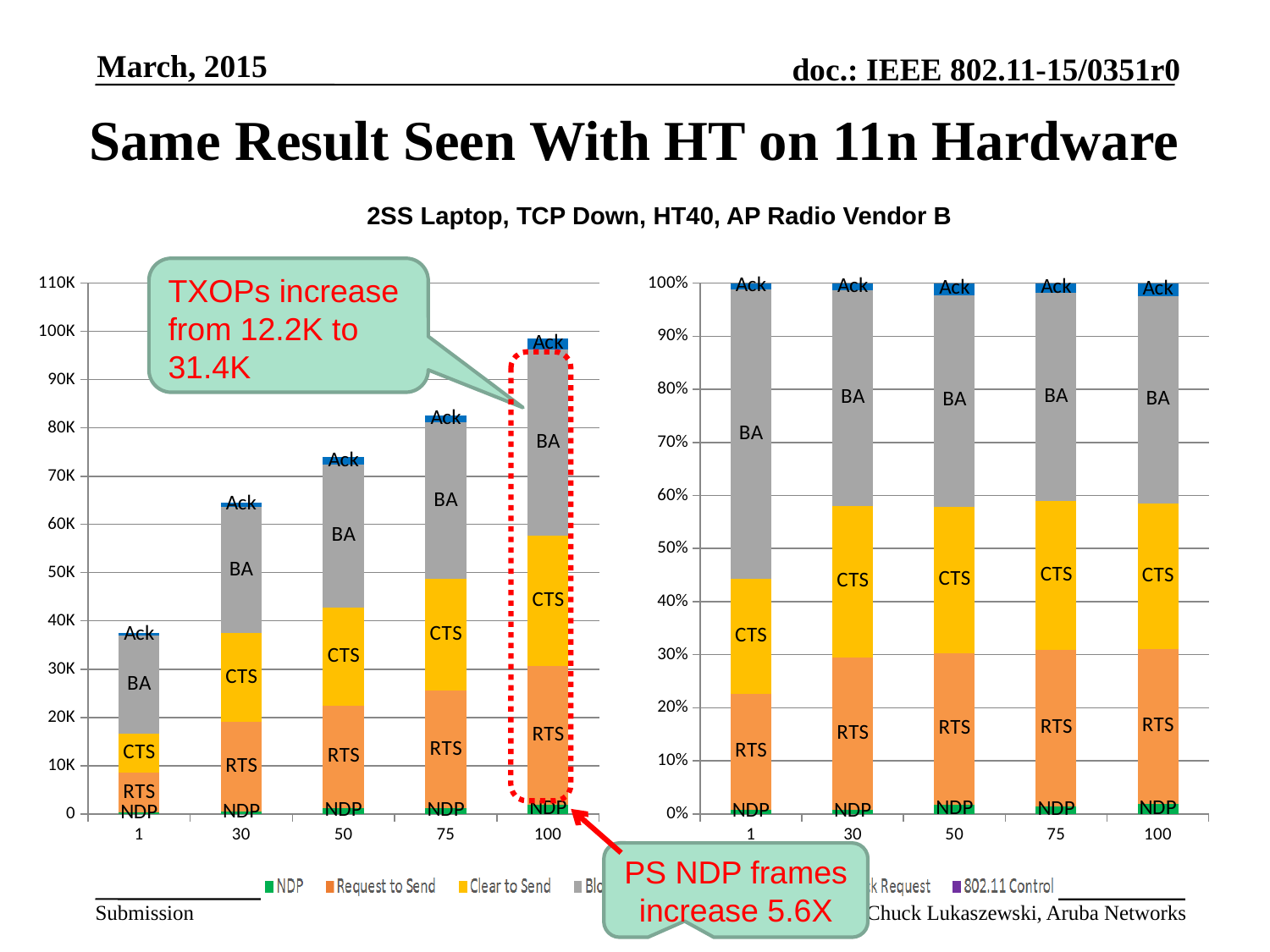
In the left chart, which x-axis category has the shortest stacked bar? 1 What kind of chart is the left chart on the slide? stacked bar chart In the left chart, is the total height of the bar for category 30 greater or less than 60K? greater In the right chart, is the RTS share larger for category 1 or for category 100? 100 According to the callout on the left chart, TXOPs increase from what value to what value? from 12.2K to 31.4K What is the subtitle printed above the two charts? 2SS Laptop, TCP Down, HT40, AP Radio Vendor B How many categories are shown on the x axis of the left chart? 5 In the left chart, which x-axis category has the tallest stacked bar? 100 In the left chart, is the total height of the bar for category 1 greater or less than 40K? less In the right chart, is the RTS share for category 100 greater or less than 20%? greater In the left chart, do the total bar heights rise or fall as the x-axis values go from 1 to 100? rise